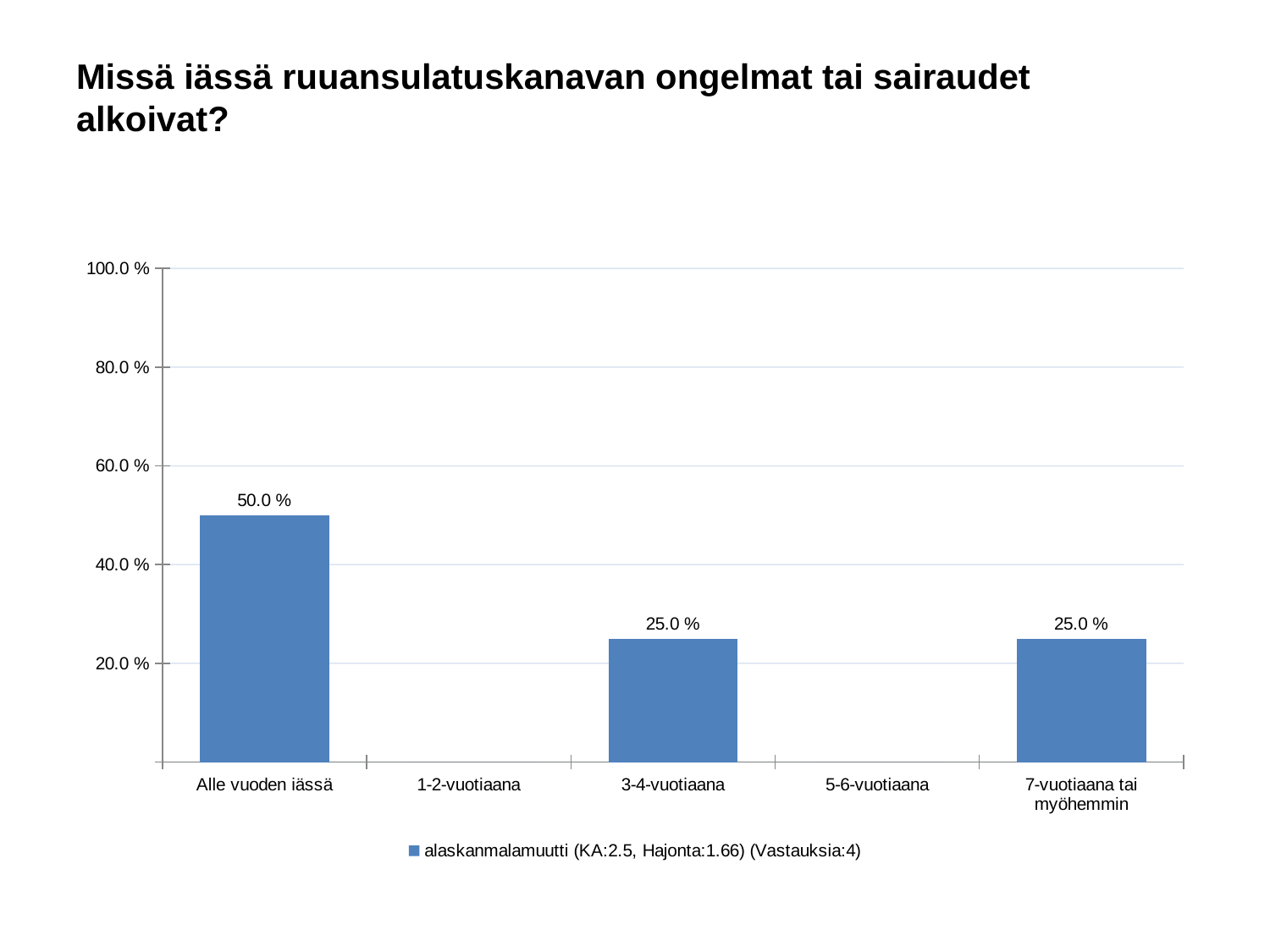
Is the value for "Alle vuoden iässä" greater or less than 40.0 %? greater What is the legend entry for the series? alaskanmalamuutti (KA:2.5, Hajonta:1.66) (Vastauksia:4) What is the value for "7-vuotiaana tai myöhemmin"? 25.0 % What is the difference between the values for "Alle vuoden iässä" and "3-4-vuotiaana"? 25.0 % How many categories are shown on the x axis? 5 What is the value for "Alle vuoden iässä"? 50.0 % What is the value for "3-4-vuotiaana"? 25.0 % What kind of chart is shown on the slide? Bar chart Which is larger, the value for "Alle vuoden iässä" or the value for "7-vuotiaana tai myöhemmin"? Alle vuoden iässä Is the value for "3-4-vuotiaana" greater or less than 40.0 %? less How many series does the legend list? 1 Which category has the highest value? Alle vuoden iässä